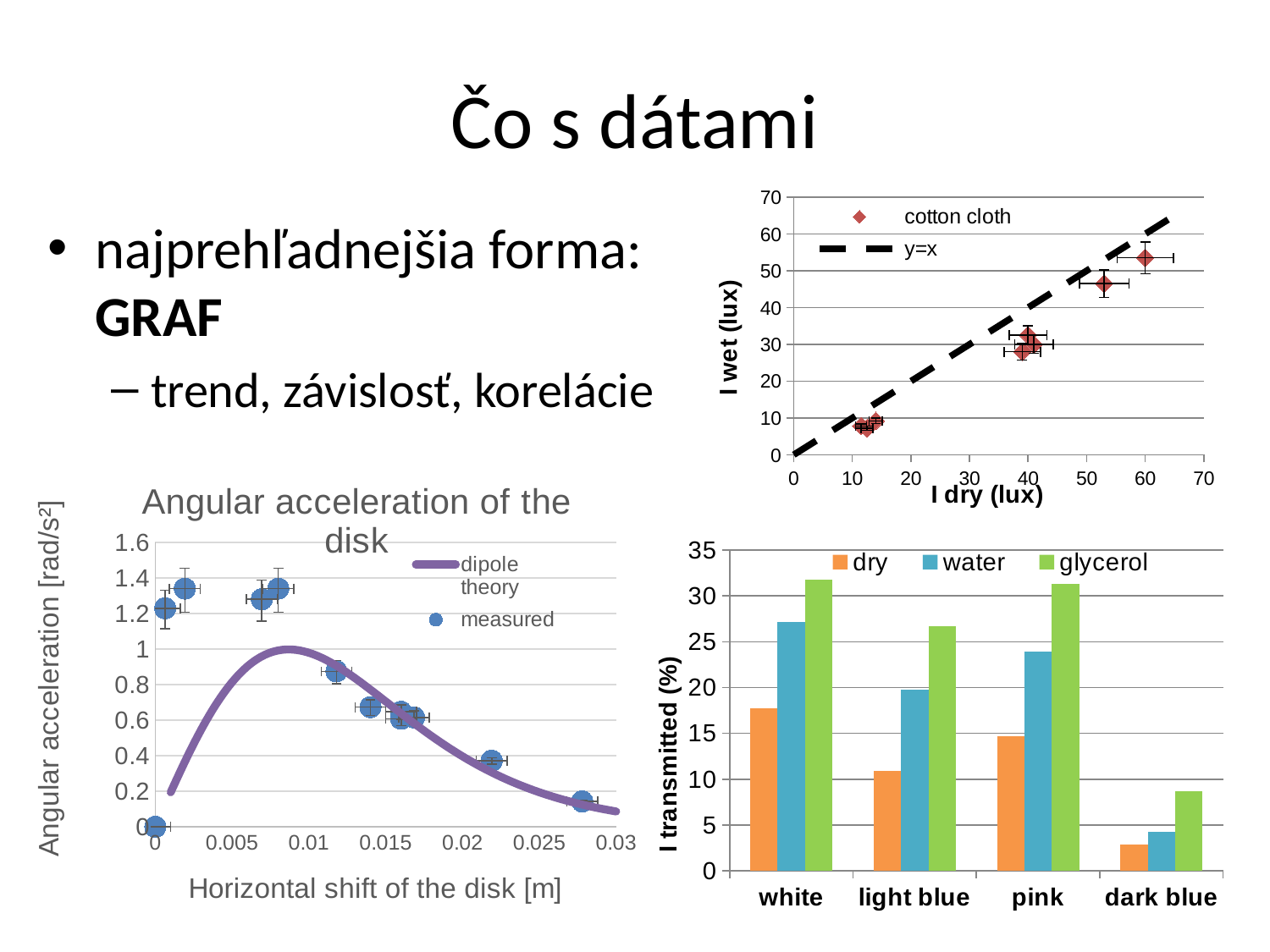
How many series does the legend of the bottom-right bar chart list? 3 How many categories are shown on the x axis of the bottom-right bar chart? 4 In the bottom-right bar chart, is the dry value for white greater or less than 15? greater How many entries does the legend of the top-right scatter chart list? 2 What kind of chart is the top-right chart with axes I dry (lux) and I wet (lux)? scatter chart In the bottom-right bar chart, is the water value for light blue greater or less than 15? greater In the bottom-right bar chart, which is larger for pink: the water value or the dry value? water In the bottom-right bar chart, which category has the highest value for the dry series? white What is the title of the bottom-left chart? Angular acceleration of the disk In the bottom-right bar chart, is the glycerol value for dark blue greater or less than 10? less What is the y-axis label of the bottom-right bar chart? I transmitted (%) In the bottom-right bar chart, which category has the lowest value for the glycerol series? dark blue